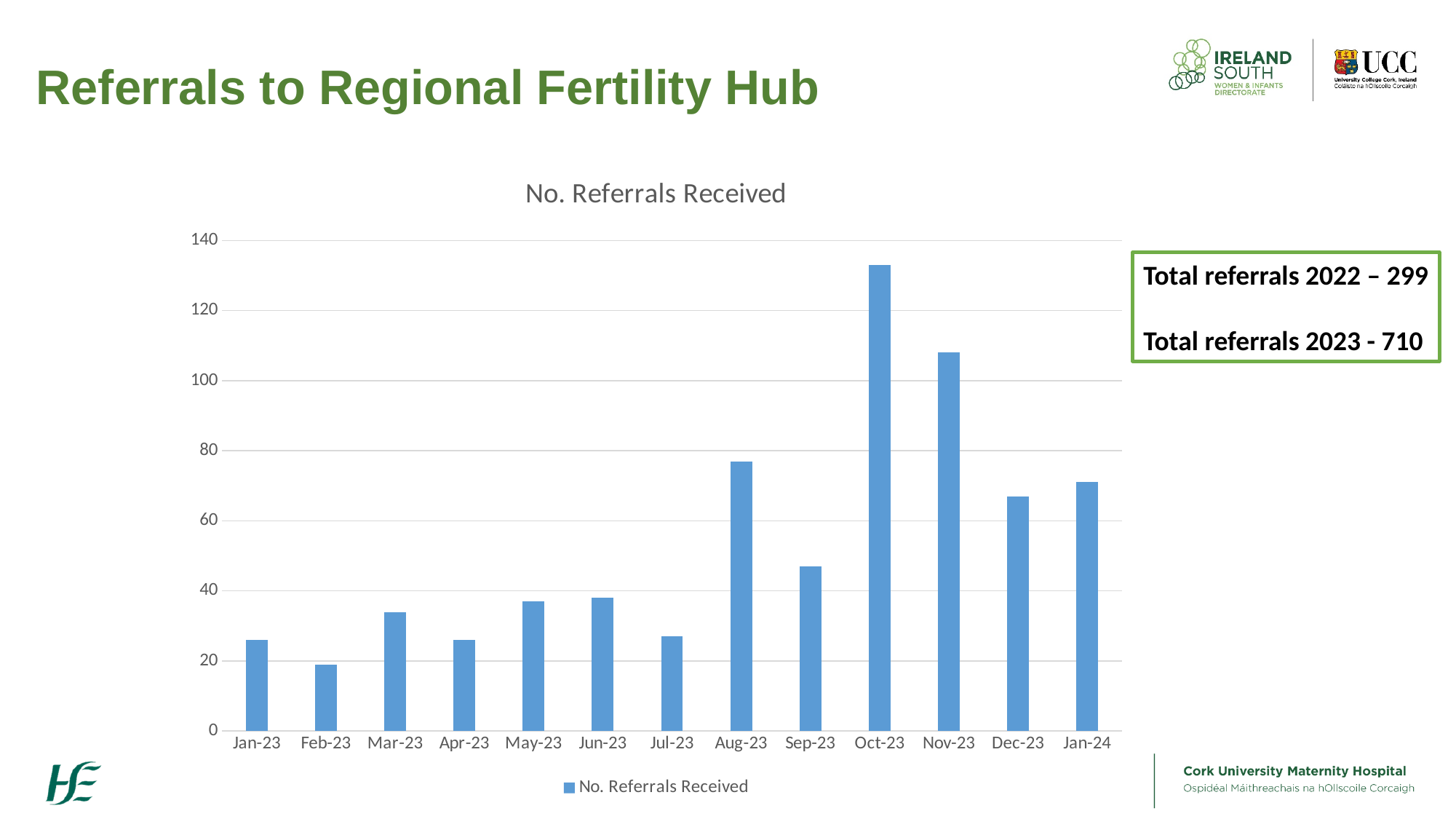
How many series does the chart's legend list? 1 How many months are shown on the x axis of the chart? 13 Which month has more referrals received, Aug-23 or Sep-23? Aug-23 Is the value for Oct-23 greater or less than 120? greater Is the value for Nov-23 greater or less than 100? greater What kind of chart is shown on the slide? Bar chart Which month has the highest number of referrals received? Oct-23 Do the values rise or fall from Oct-23 to Dec-23? Fall Which month has the lowest number of referrals received? Feb-23 Which month has more referrals received, Nov-23 or Dec-23? Nov-23 Is the value for Aug-23 greater or less than 80? less